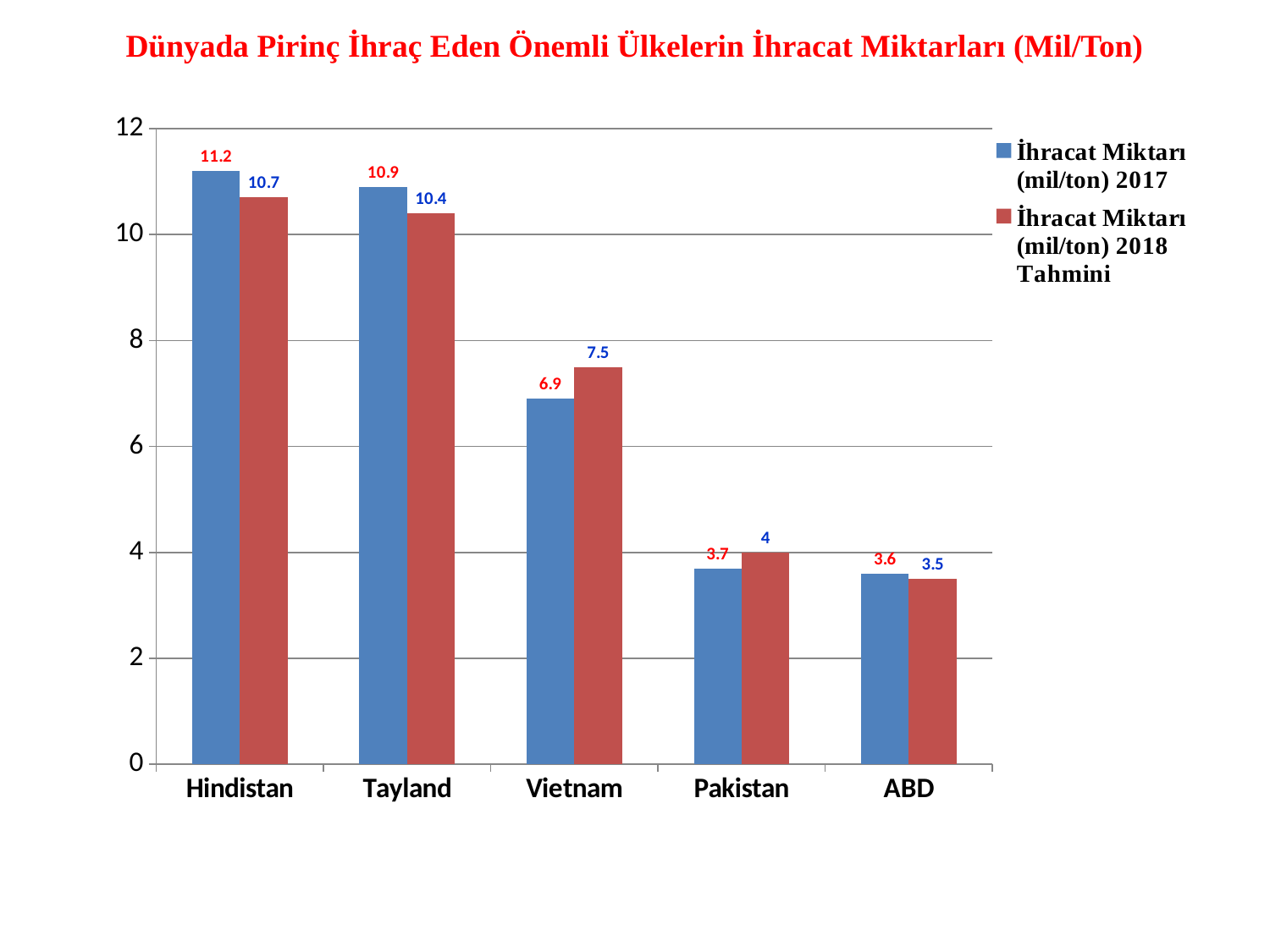
What is the title of the chart? Dünyada Pirinç İhraç Eden Önemli Ülkelerin İhracat Miktarları (Mil/Ton) How many series does the legend list? 2 What is the 2018 estimated export amount (İhracat Miktarı (mil/ton) 2018 Tahmini) for Vietnam? 7.5 Which is larger for Vietnam: the 2017 export amount or the 2018 estimate? 2018 estimate (7.5) What is the 2018 estimated export amount for Pakistan? 4 What is the 2017 export amount (İhracat Miktarı (mil/ton) 2017) for Hindistan? 11.2 What is the difference between Hindistan's 2017 export amount and its 2018 estimate? 0.5 Which country has the highest 2017 export amount? Hindistan Is the 2017 export amount for Tayland greater or less than 10? greater Which country has the lowest 2018 estimated export amount? ABD How many countries are shown on the x axis? 5 What kind of chart is shown on the slide? Bar chart